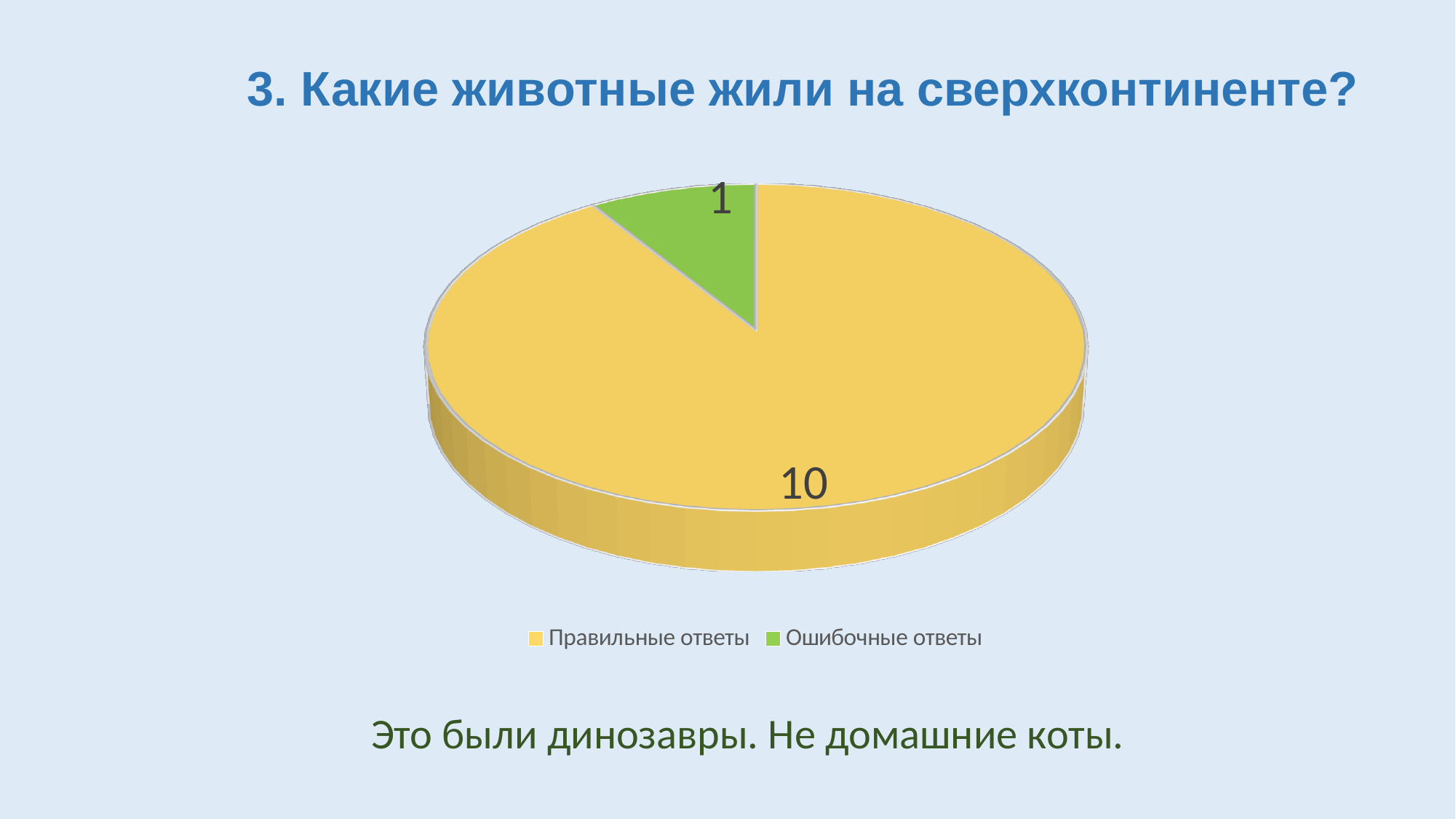
What is the value for Ошибочные ответы? 1 What is the difference between the values for Правильные ответы and Ошибочные ответы? 9 Which category has the smallest slice? Ошибочные ответы Which is larger, Правильные ответы or Ошибочные ответы? Правильные ответы What kind of chart is shown on the slide? pie chart What colour is the slice for Ошибочные ответы? green What is the title of the slide above the chart? 3. Какие животные жили на сверхконтиненте? What is the value for Правильные ответы? 10 Which category has the largest slice? Правильные ответы How many slices does the pie chart have? 2 How many entries does the legend list? 2 What is the total of all slices in the pie chart? 11